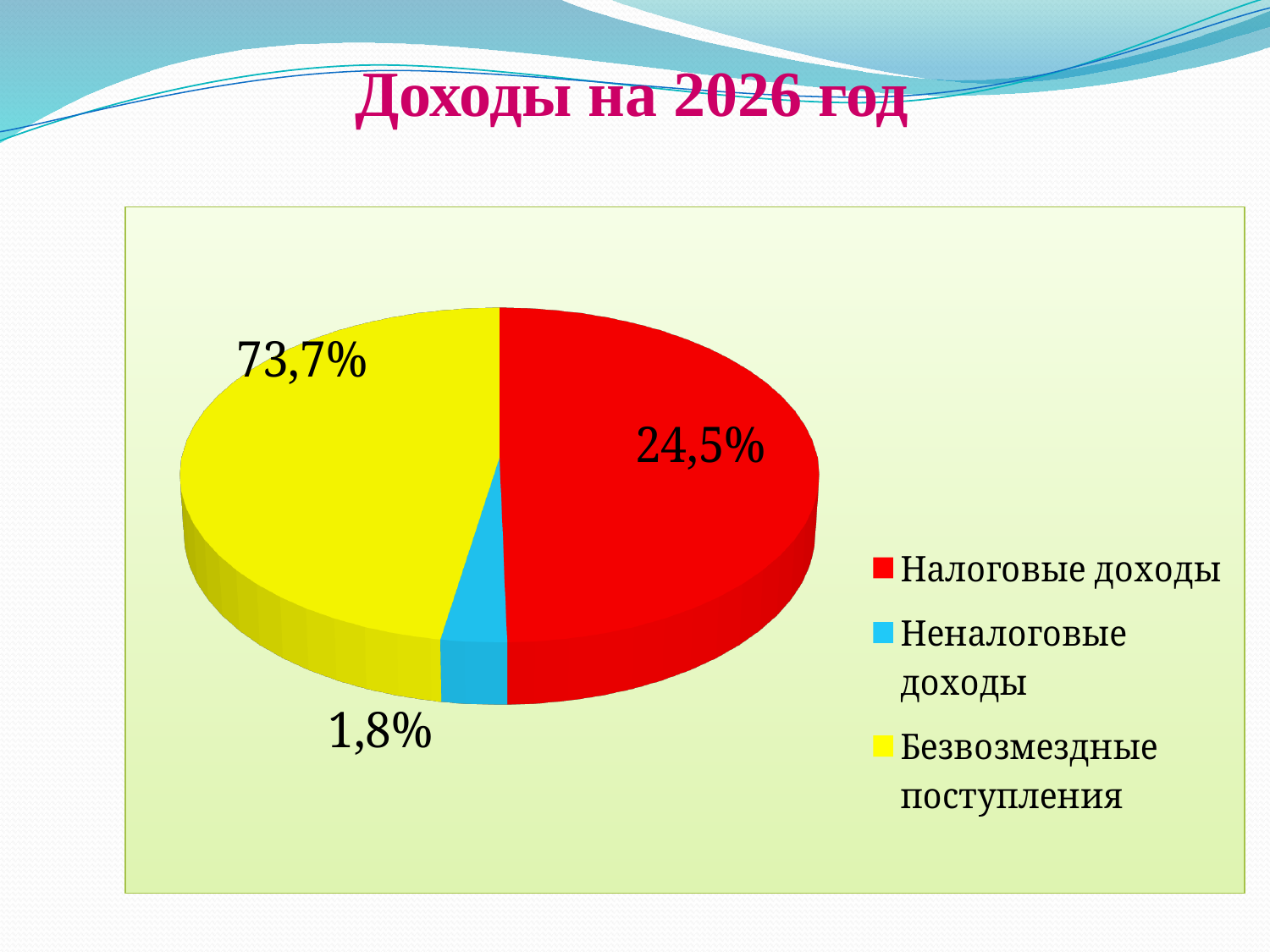
Which is larger, the share for Налоговые доходы or the share for Неналоговые доходы? Налоговые доходы What share of the pie does Безвозмездные поступления have? 73,7% What is the title of the slide? Доходы на 2026 год What is the difference in percentage points between Налоговые доходы and Неналоговые доходы? 22,7 What colour is the slice for Безвозмездные поступления? yellow Which category has the largest share of the pie? Безвозмездные поступления What share of the pie does Неналоговые доходы have? 1,8% How many slices does the pie chart have? 3 What kind of chart is shown on the slide? pie chart Which category has the smallest share of the pie? Неналоговые доходы What share of the pie does Налоговые доходы have? 24,5% What is the difference in percentage points between Безвозмездные поступления and Налоговые доходы? 49,2